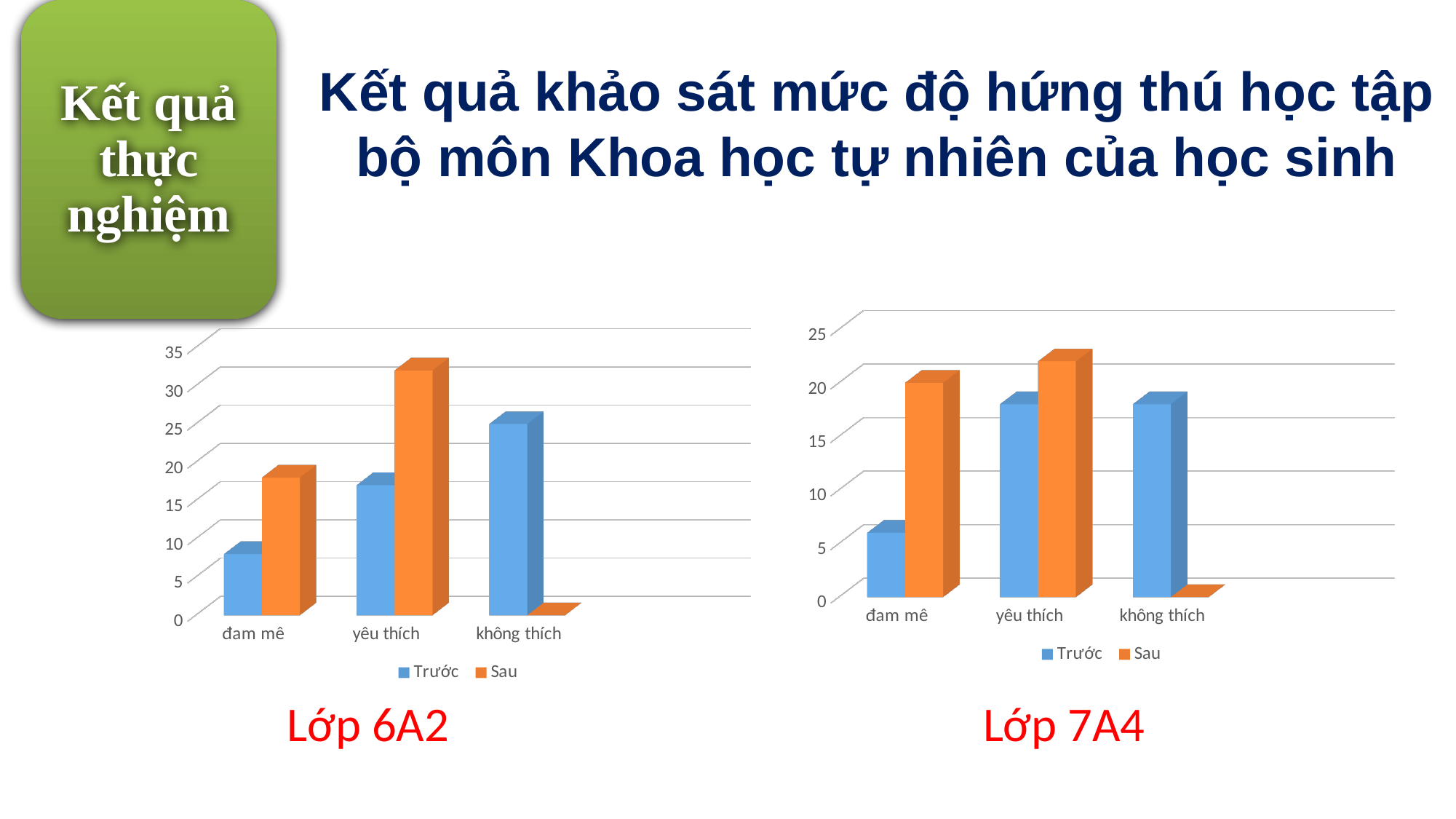
What kind of chart is the Lớp 6A2 chart? bar chart How many categories are shown on the x axis of the Lớp 7A4 chart? 3 In the Lớp 7A4 chart, is the Trước value for đam mê greater or less than 10? less In the Lớp 6A2 chart, is the Sau value for yêu thích greater or less than 25? greater In the Lớp 6A2 chart, which category has the highest Sau bar? yêu thích In the Lớp 7A4 chart, is the Sau value for đam mê greater or less than 15? greater What are the two legend entries of the Lớp 7A4 chart? Trước and Sau In the Lớp 6A2 chart, which category has the lowest Sau bar? không thích In the Lớp 6A2 chart, for đam mê, which is larger: Trước or Sau? Sau In the Lớp 7A4 chart, which category has the highest Sau bar? yêu thích How many series does the legend of the Lớp 6A2 chart list? 2